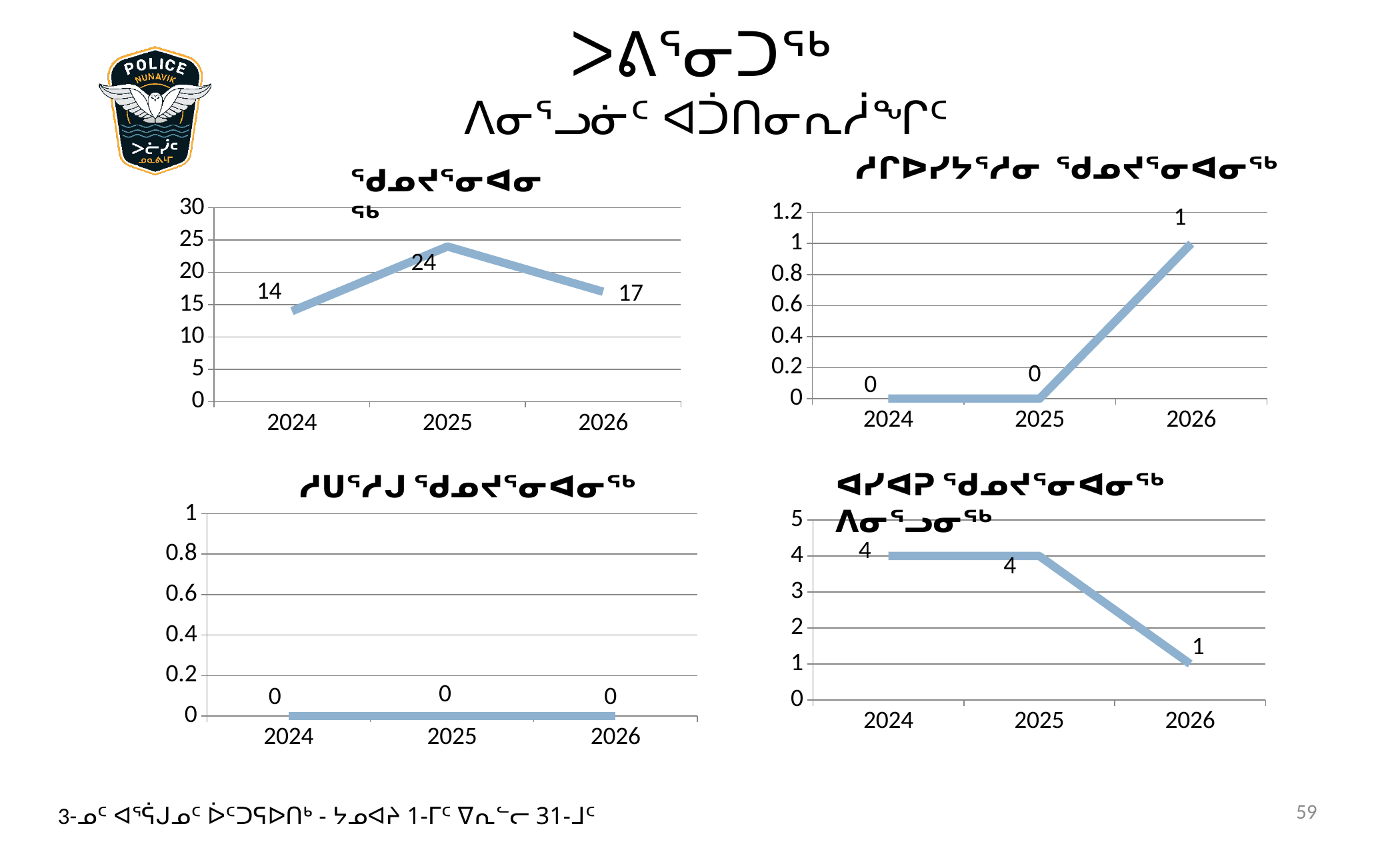
In the top-left chart, what is the difference between the values for 2025 and 2026? 7 In the bottom-left chart, what is the value for 2026? 0 In the top-right chart, what is the value for 2026? 1 In the top-right chart, what is the value for 2025? 0 In the top-left chart, which year has the highest value? 2025 In the top-left chart, what is the value for 2024? 14 In the bottom-right chart, what is the value for 2026? 1 What kind of chart is the top-left chart? line chart In the top-left chart, what is the value for 2025? 24 In the bottom-right chart, which is larger, the value for 2024 or the value for 2026? 2024 In the bottom-right chart, do the values rise or fall from 2025 to 2026? fall In the top-left chart, which year has the lowest value? 2024